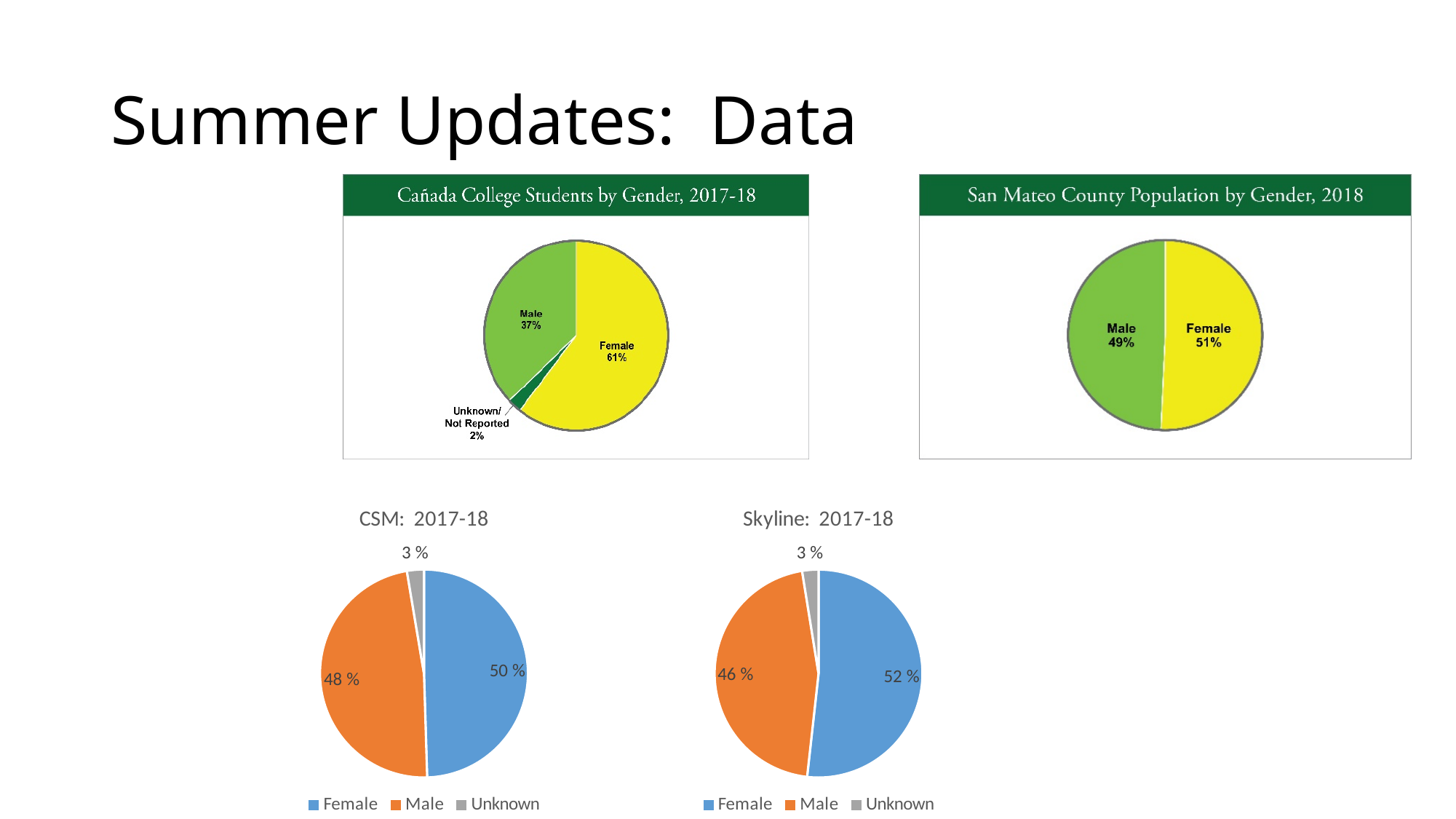
In the 'CSM: 2017-18' chart, what share is Male? 48 % In the 'Cañada College Students by Gender, 2017-18' chart, what share is Unknown/Not Reported? 2% How many entries does the legend of the 'Skyline: 2017-18' chart list? 3 In the 'Cañada College Students by Gender, 2017-18' chart, what share of students is Female? 61% What type of chart is the 'CSM: 2017-18' chart? Pie chart In the 'San Mateo County Population by Gender, 2018' chart, what share is Male? 49% In the 'Skyline: 2017-18' chart, what share is Female? 52 % In the 'Cañada College Students by Gender, 2017-18' chart, which category has the largest slice? Female In the 'Skyline: 2017-18' chart, which is larger, the Female share or the Male share? Female In the 'CSM: 2017-18' chart, what share is Unknown? 3 % In the 'Cañada College Students by Gender, 2017-18' chart, what is the difference between the Female and Male shares? 24% In the 'San Mateo County Population by Gender, 2018' chart, how many slices does the pie have? 2